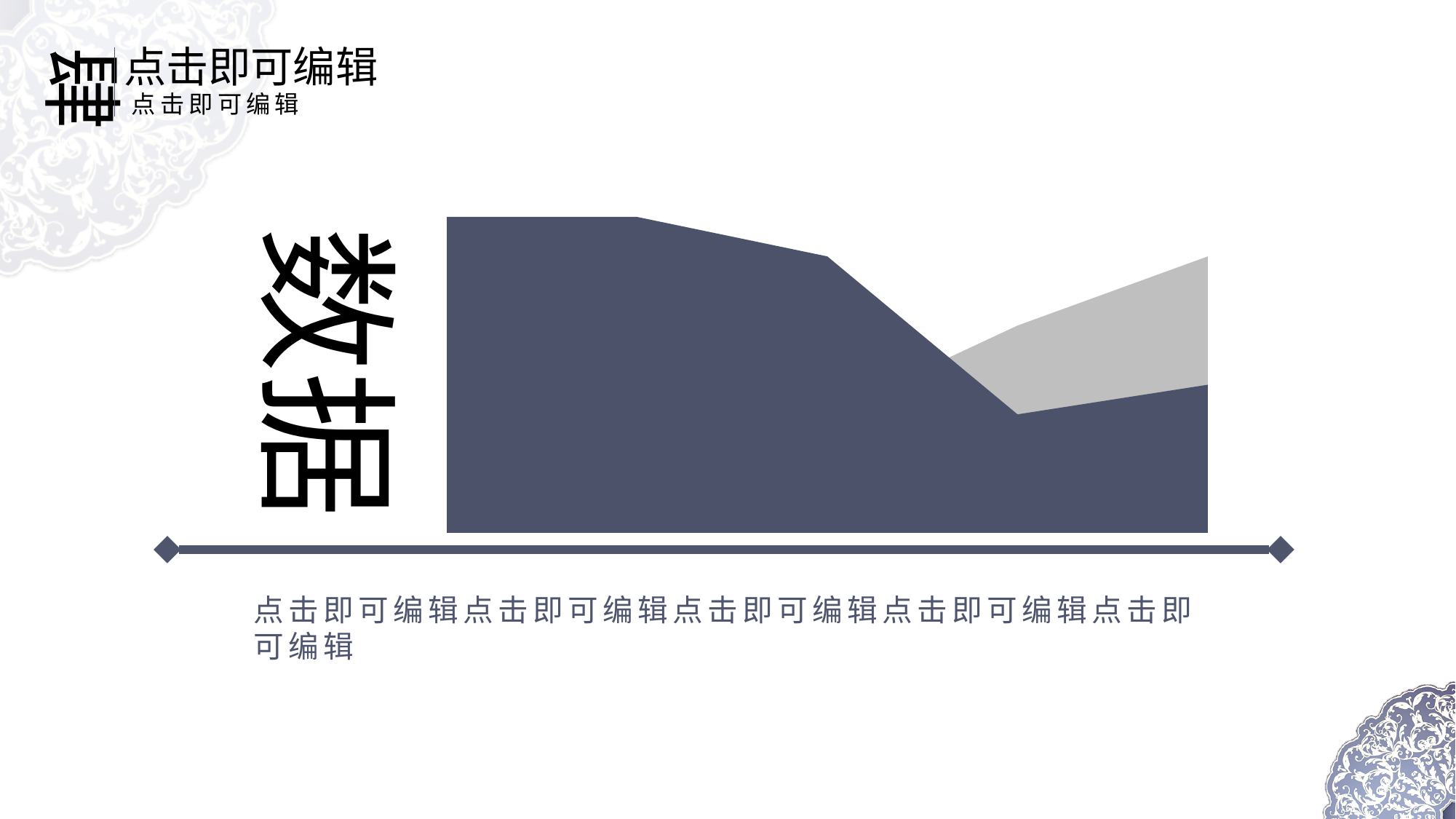
Does the light gray series rise or fall toward the right end of the chart? rise At the leftmost point of the chart, which series is higher, the dark blue or the light gray? dark blue Does the dark blue series overall rise or fall from left to right? fall At the rightmost point of the chart, which series is higher, the dark blue or the light gray? light gray What kind of chart is shown on the slide? area chart Does the chart display a legend? No How many data points does the dark blue series have? 5 How many differently coloured areas are plotted in the chart? 2